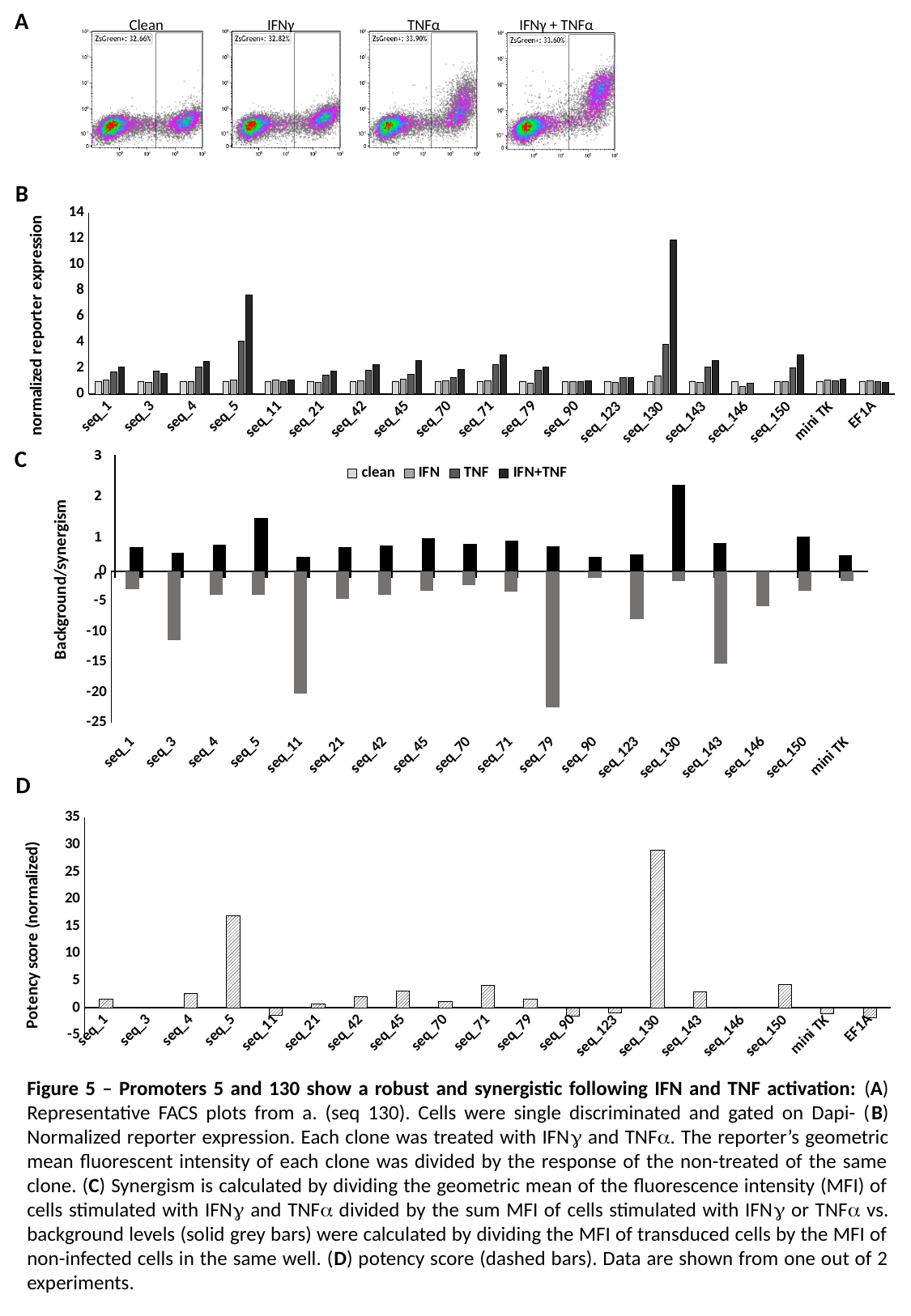
In chart D (Potency score), which category has the highest bar? seq_130 In chart B (normalized reporter expression), which has the larger IFN+TNF value, seq_5 or seq_130? seq_130 In chart B (normalized reporter expression), is the IFN+TNF value for seq_130 greater or less than 10? greater In chart C (Background/synergism), which category has the lowest (most negative) bar? seq_79 How many categories are shown on the x axis of chart B (normalized reporter expression)? 19 How many series does the legend list for chart B (normalized reporter expression)? 4 In chart C (Background/synergism), which category has the highest positive bar? seq_130 In chart D (Potency score), is the value for seq_5 greater or less than 15? greater In chart B (normalized reporter expression), which category has the highest IFN+TNF bar? seq_130 How many categories are shown on the x axis of chart C (Background/synergism)? 18 In chart B (normalized reporter expression), is the IFN+TNF value for seq_5 greater or less than 6? greater What kind of chart is chart B (normalized reporter expression)? bar chart